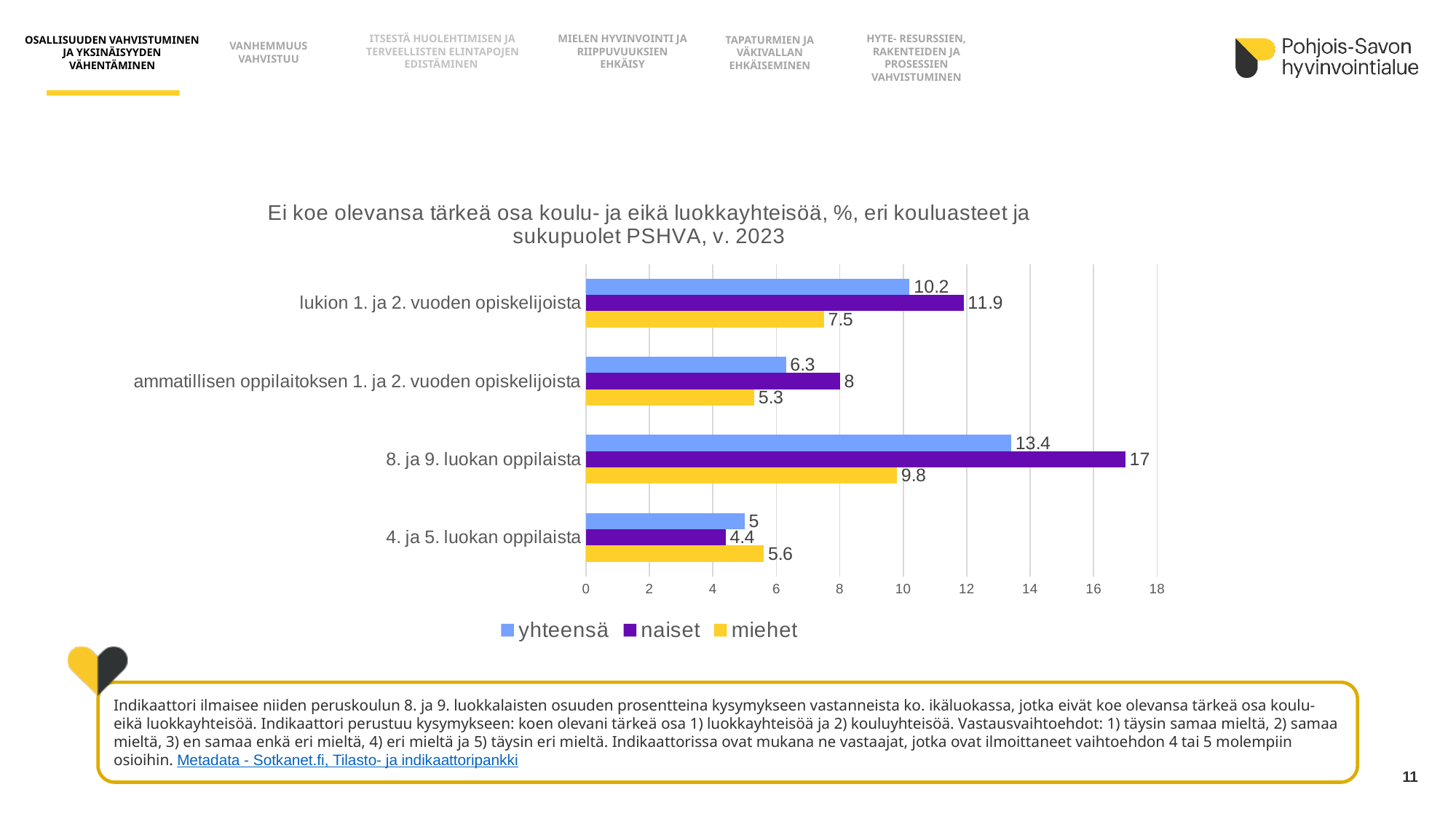
What is the difference between the naiset and miehet values for 8. ja 9. luokan oppilaista? 7.2 Which series is shown in yellow in the legend? miehet Which category has the lowest yhteensä value? 4. ja 5. luokan oppilaista What is the value for miehet among lukion 1. ja 2. vuoden opiskelijoista? 7.5 Which category has the highest naiset value? 8. ja 9. luokan oppilaista Is the yhteensä value for 8. ja 9. luokan oppilaista greater or less than 12? greater For 4. ja 5. luokan oppilaista, which is larger, the naiset value or the miehet value? miehet What is the yhteensä value for ammatillisen oppilaitoksen 1. ja 2. vuoden opiskelijoista? 6.3 How many series does the legend list? 3 How many categories are shown on the chart? 4 What kind of chart is shown on the slide? bar chart What is the value for naiset among 8. ja 9. luokan oppilaista? 17